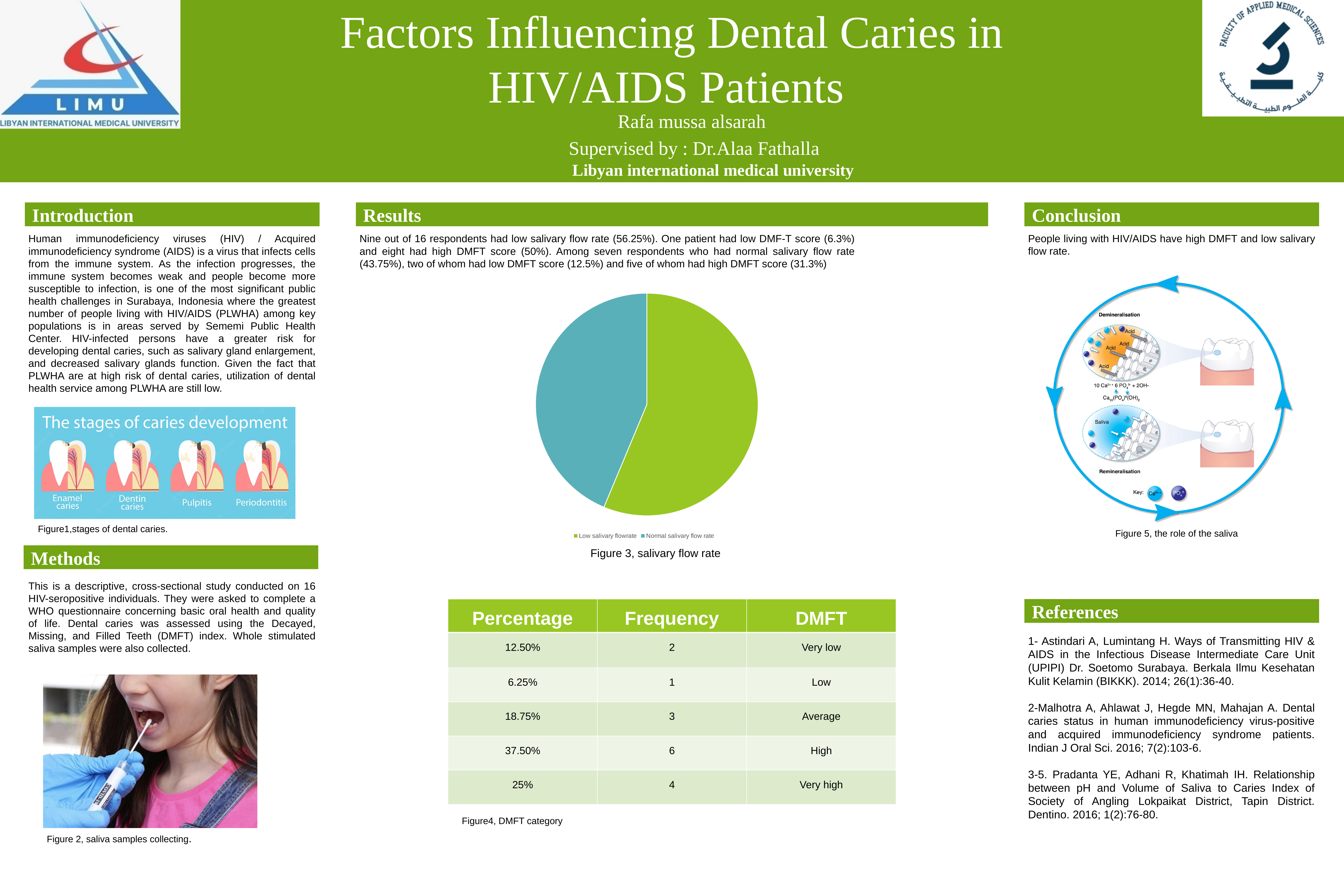
Which category has the smallest share in the Figure 3 pie chart? Normal salivary flow rate How many slices does the pie chart in Figure 3 have? 2 Which category has the largest share in the Figure 3 pie chart? Low salivary flowrate How many entries does the legend of the Figure 3 pie chart list? 2 What kind of chart is Figure 3, salivary flow rate? pie chart What is the caption of the pie chart on the slide? Figure 3, salivary flow rate In the Figure 3 pie chart, which slice is larger: Low salivary flowrate or Normal salivary flow rate? Low salivary flowrate What colour is the Low salivary flowrate slice in the Figure 3 pie chart? green